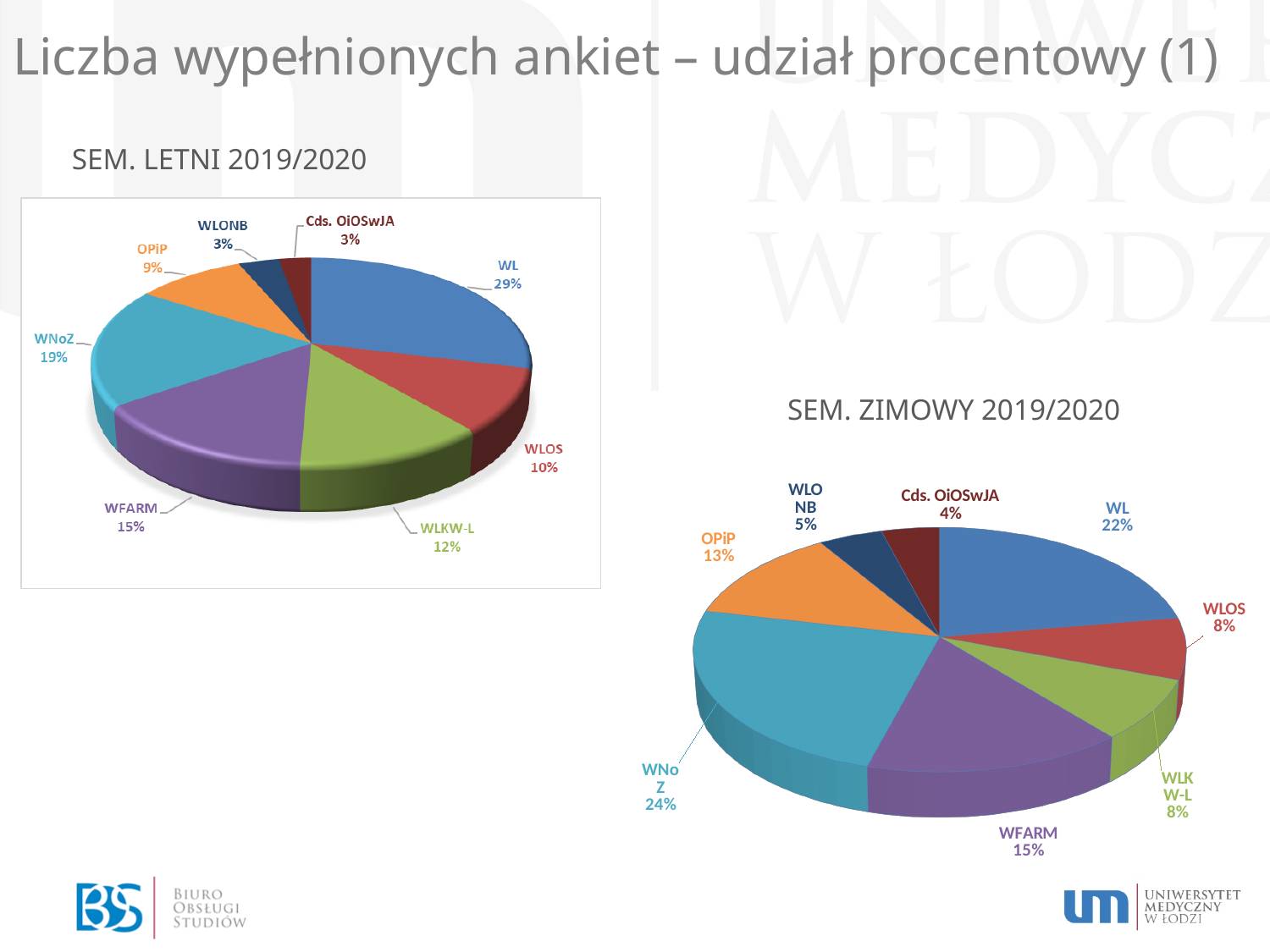
How many categories are shown in the SEM. LETNI 2019/2020 chart? 8 In the SEM. LETNI 2019/2020 chart, what share does OPiP have? 9% In the SEM. ZIMOWY 2019/2020 chart, which category has the largest share? WNoZ In the SEM. ZIMOWY 2019/2020 chart, which category has the smallest share? Cds. OiOSwJA What is the title of the chart on the left side of the slide? SEM. LETNI 2019/2020 In the SEM. ZIMOWY 2019/2020 chart, what share does WNoZ have? 24% In the SEM. ZIMOWY 2019/2020 chart, what share does WLONB have? 5% In the SEM. LETNI 2019/2020 chart, which category has the largest share? WL What kind of chart is the SEM. ZIMOWY 2019/2020 chart? Pie chart In the SEM. ZIMOWY 2019/2020 chart, which is larger, the share of OPiP or the share of WLOS? OPiP In the SEM. LETNI 2019/2020 chart, what share does WL have? 29% In the SEM. LETNI 2019/2020 chart, what is the difference between the shares of WNoZ and WFARM? 4%